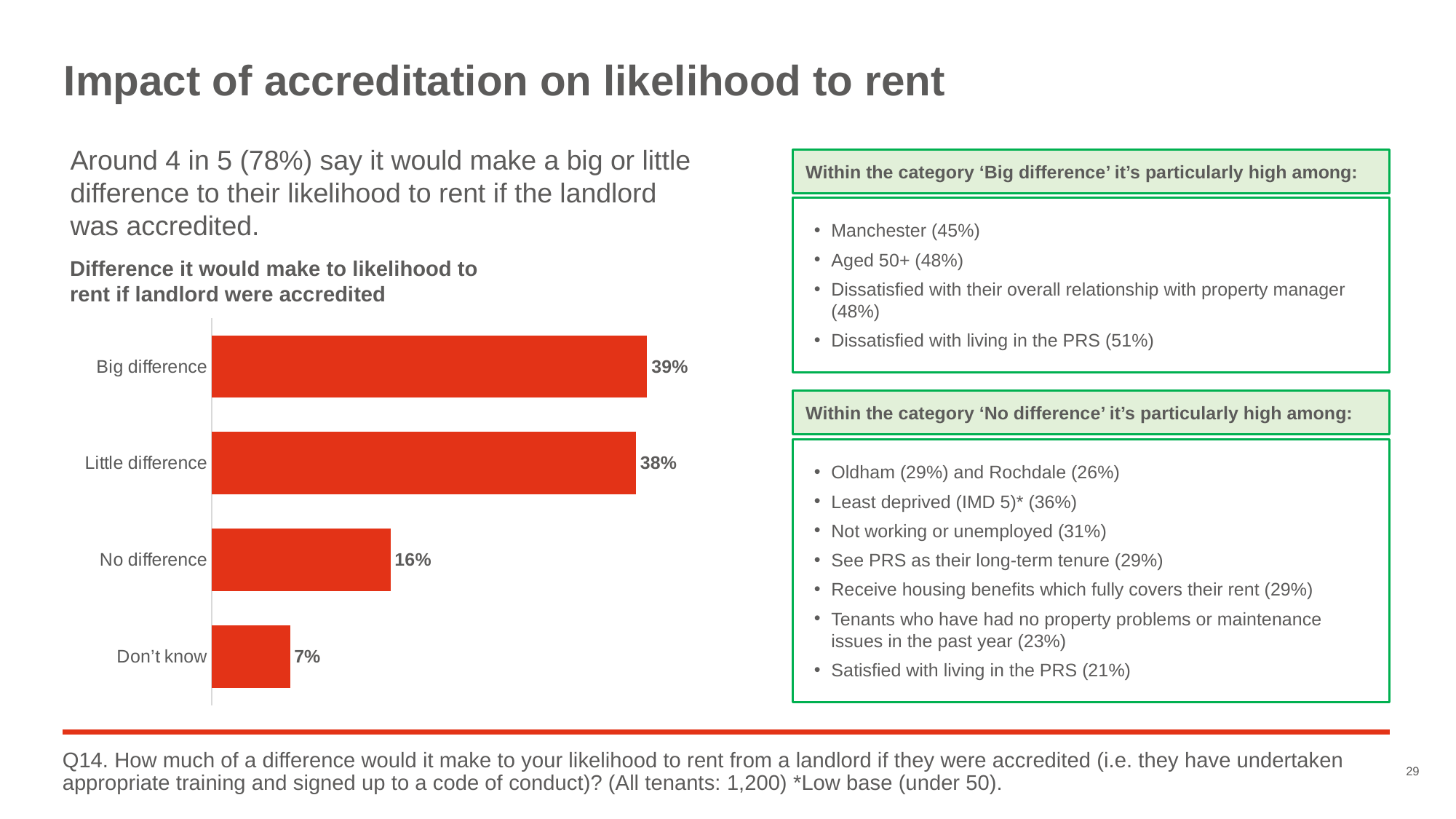
Which category has the highest value in the chart? Big difference What type of chart is used on this slide? Bar chart What percentage of tenants said accreditation would make no difference? 16% Which category has the lowest value in the chart? Don't know How many categories are shown in the chart? 4 Which is larger: the value for 'No difference' or the value for 'Don't know'? No difference What percentage of tenants said accreditation would make a big difference to their likelihood to rent? 39% What is the value shown for 'Little difference'? 38% What is the difference in percentage points between 'No difference' and 'Don't know'? 9 What is the difference in percentage points between 'Big difference' and 'No difference'? 23 What is the value shown for 'Don't know'? 7% What is the title of the chart? Difference it would make to likelihood to rent if landlord were accredited